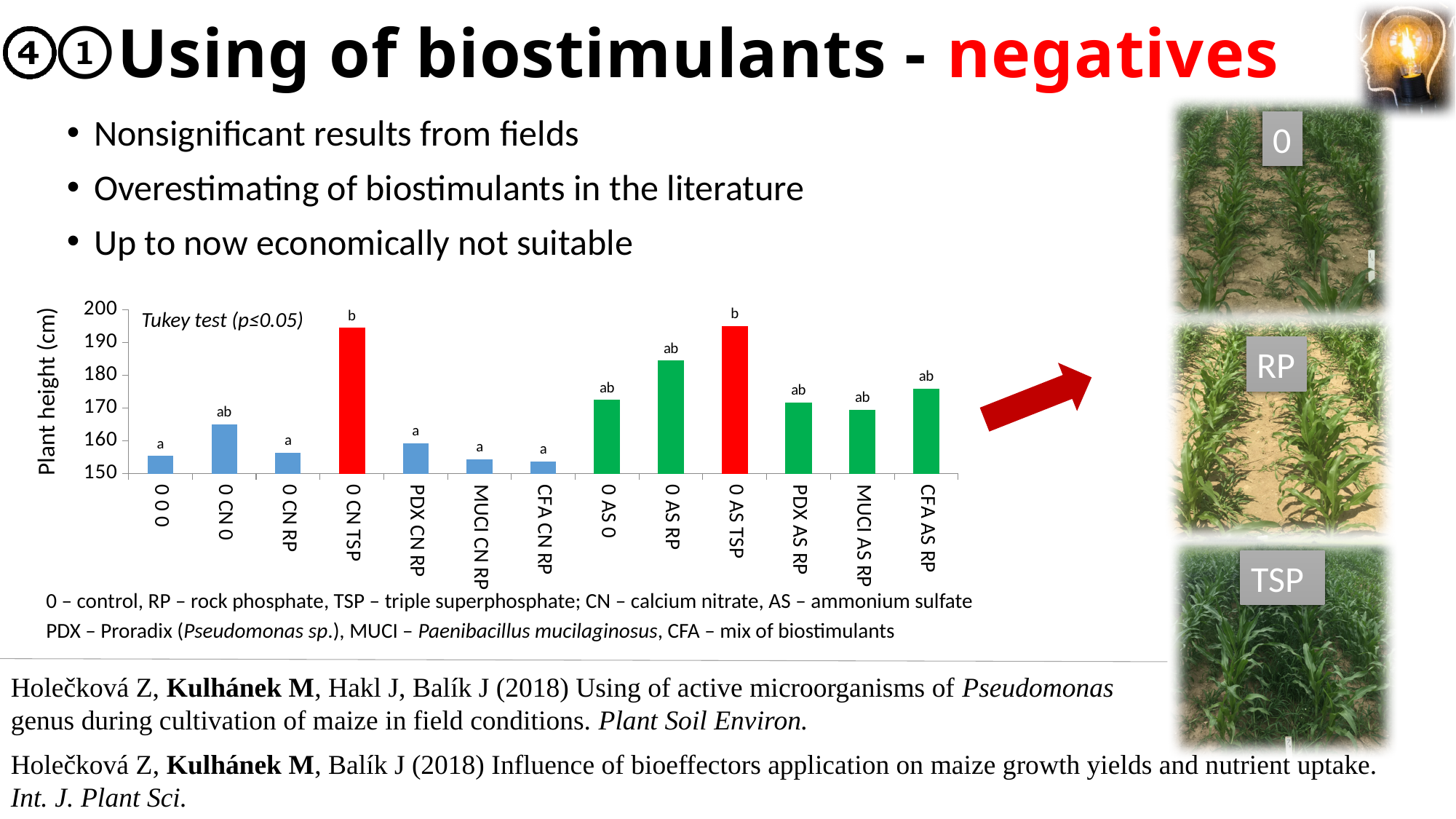
Which has the greater plant height, CFA AS RP or MUCI AS RP? CFA AS RP Is the plant height for 0 CN 0 greater or less than 160? greater Is the plant height for 0 0 0 greater or less than 160? less What kind of chart is shown on the slide? bar chart Which statistical test is named in the annotation inside the chart? Tukey test (p≤0.05) Is the plant height for 0 AS RP greater or less than 180? greater What is the label of the y axis of the chart? Plant height (cm) Which has the greater plant height, 0 AS RP or 0 AS 0? 0 AS RP How many treatment categories are plotted on the x axis of the chart? 13